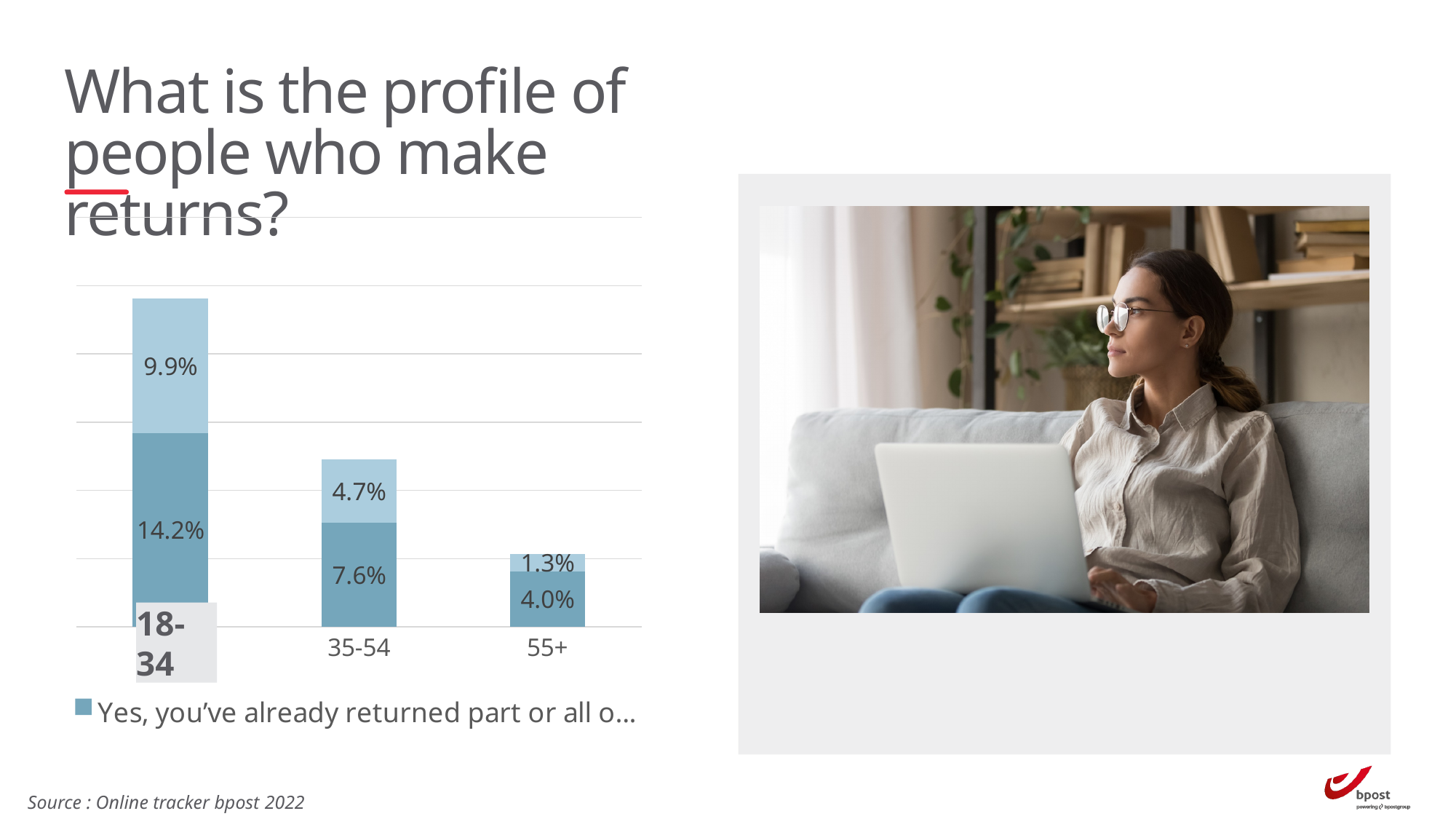
Which age group has the larger lighter (top) segment value, 18-34 or 35-54? 18-34 What kind of chart is shown on the slide? Stacked bar chart What is the total of the stacked bar for the 18-34 age group? 24.1% Which age group has the shortest stacked bar? 55+ Which age group has the tallest stacked bar? 18-34 How many age groups are shown on the x axis? 3 What is the value of the lighter (top) segment for the 55+ age group? 1.3% What is the value of the darker (bottom) segment for the 55+ age group? 4.0% What is the value of the darker (bottom) segment for the 18-34 age group? 14.2% What is the difference between the darker (bottom) segment values for 18-34 and 35-54? 6.6% What is the value of the lighter (top) segment for the 35-54 age group? 4.7% Do the stacked bar totals rise or fall as age increases along the x axis? Fall